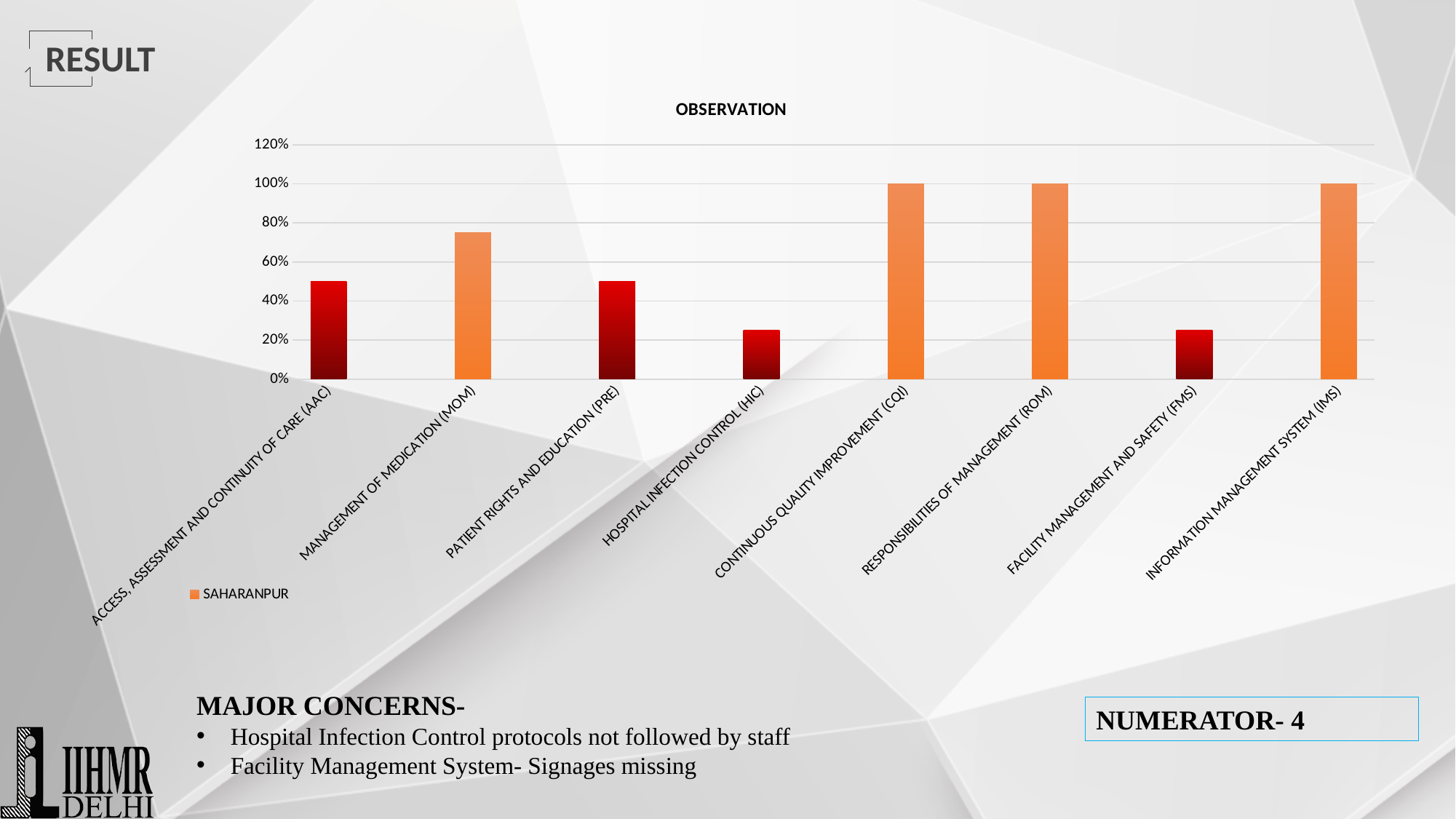
What is the value for RESPONSIBILITIES OF MANAGEMENT (ROM)? 100% What is the value for INFORMATION MANAGEMENT SYSTEM (IMS)? 100% Which is larger, the value for MANAGEMENT OF MEDICATION (MOM) or the value for ACCESS, ASSESSMENT AND CONTINUITY OF CARE (AAC)? MANAGEMENT OF MEDICATION (MOM) What type of chart is shown on the slide? bar chart How many series does the chart's legend list? 1 What is the title of the chart? OBSERVATION What series name appears in the chart's legend? SAHARANPUR What is the value for CONTINUOUS QUALITY IMPROVEMENT (CQI)? 100% Is the value for MANAGEMENT OF MEDICATION (MOM) greater or less than 60%? greater How many categories are shown on the x axis of the chart? 8 Which is larger, the value for FACILITY MANAGEMENT AND SAFETY (FMS) or the value for PATIENT RIGHTS AND EDUCATION (PRE)? PATIENT RIGHTS AND EDUCATION (PRE) Is the value for HOSPITAL INFECTION CONTROL (HIC) greater or less than 40%? less